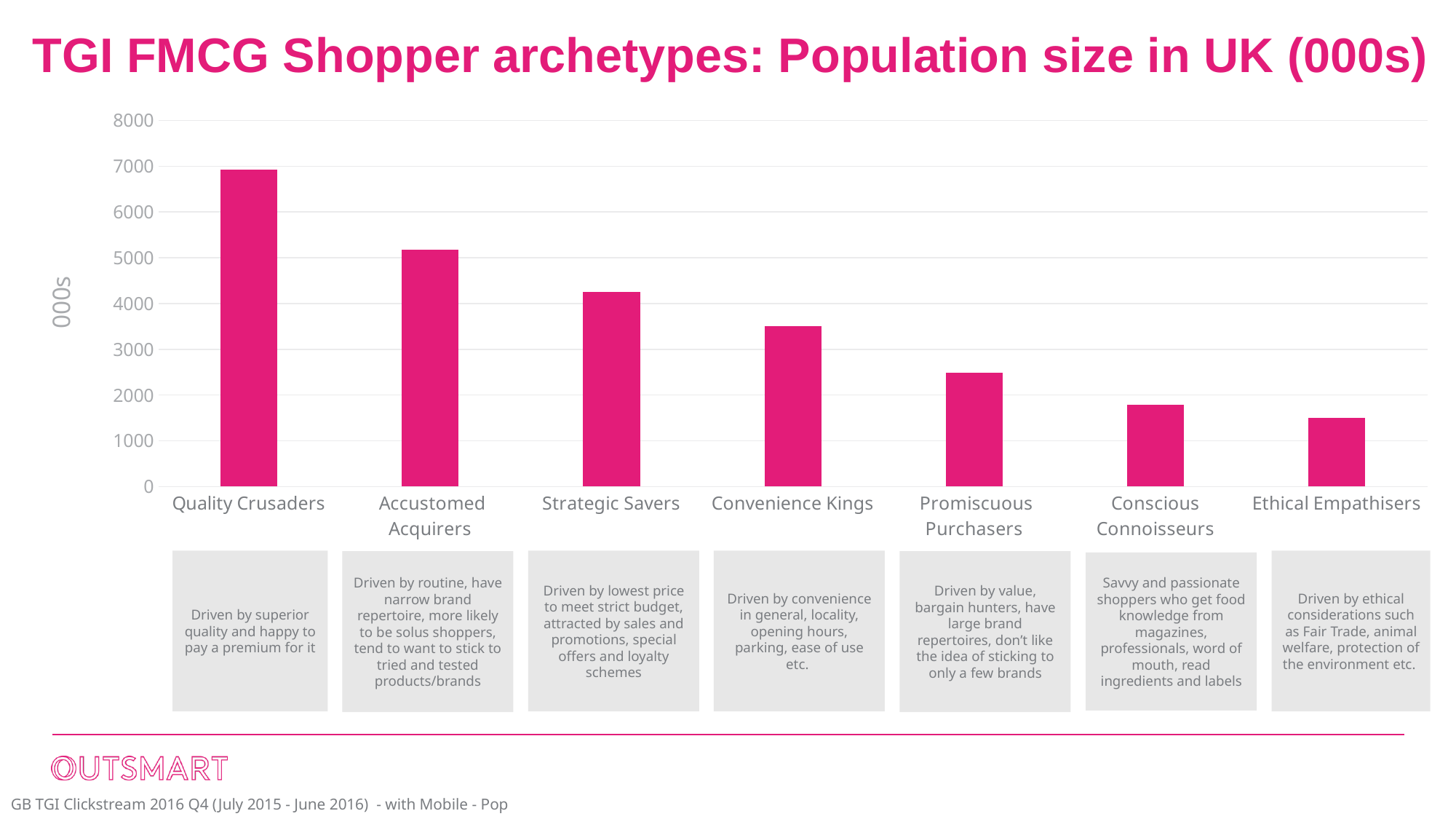
Is the value for Promiscuous Purchasers greater or less than 2000? greater What kind of chart is shown on the slide? bar chart How many shopper archetypes are plotted on the chart? 7 Is the value for Quality Crusaders greater or less than 6000? greater Is the value for Convenience Kings greater or less than 4000? less Which shopper archetype has the largest population? Quality Crusaders Do the bar values rise or fall from left to right across the chart? fall Which has a larger population, Accustomed Acquirers or Strategic Savers? Accustomed Acquirers What is the label on the vertical axis of the chart? 000s Which shopper archetype has the smallest population? Ethical Empathisers